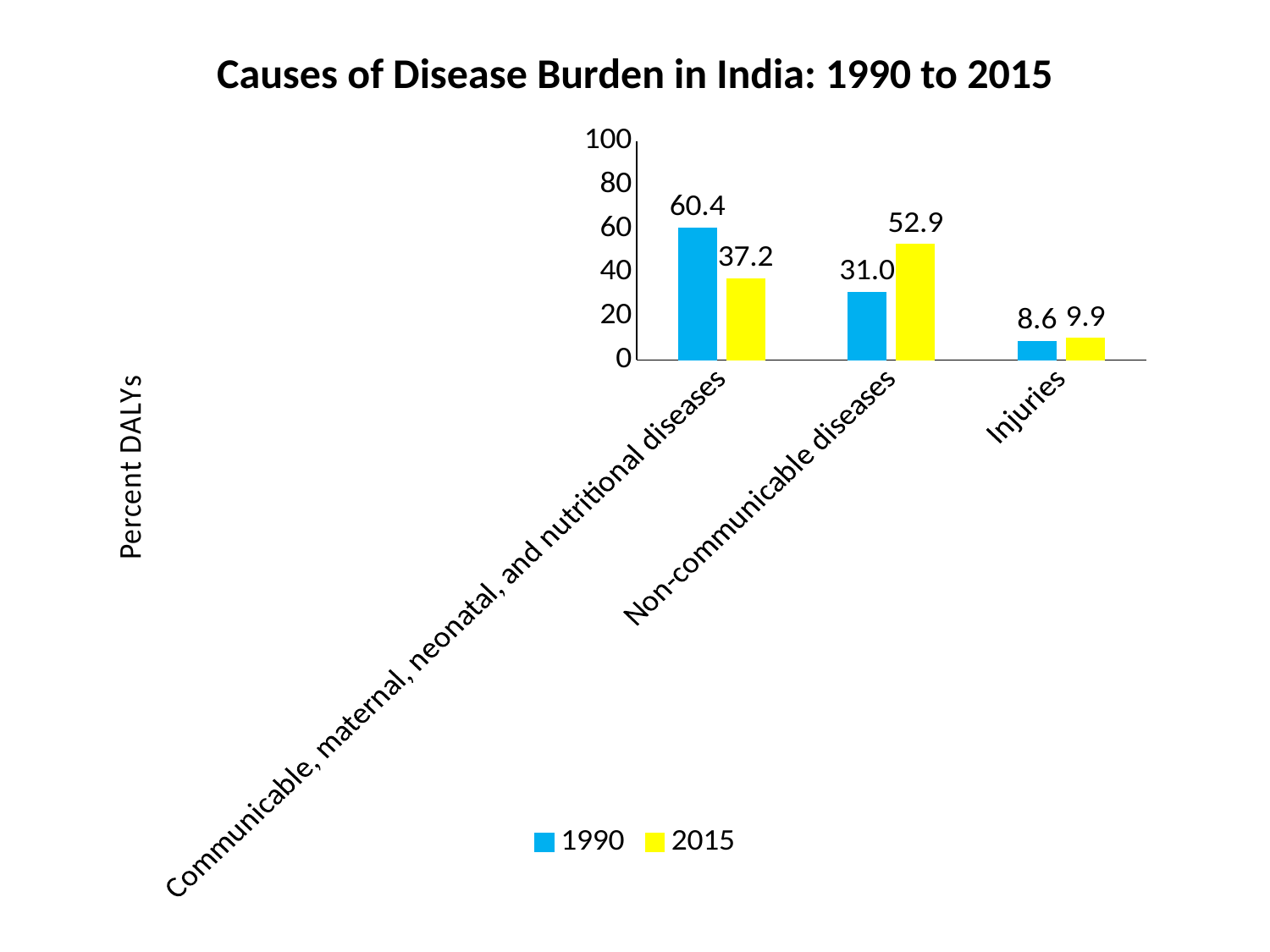
What is the 2015 value for Communicable, maternal, neonatal, and nutritional diseases? 37.2 What is the difference between the 1990 and 2015 values for Communicable, maternal, neonatal, and nutritional diseases? 23.2 How many series does the legend list? 2 What is the 2015 value for Injuries? 9.9 How many categories are shown on the x axis? 3 What is the 1990 value for Non-communicable diseases? 31.0 What kind of chart is shown on the slide? Bar chart Which category has the lowest 2015 value? Injuries Which is larger for Non-communicable diseases, the 1990 value or the 2015 value? 2015 What is the difference between the 2015 and 1990 values for Non-communicable diseases? 21.9 What is the label on the vertical axis? Percent DALYs Which category has the highest 1990 value? Communicable, maternal, neonatal, and nutritional diseases